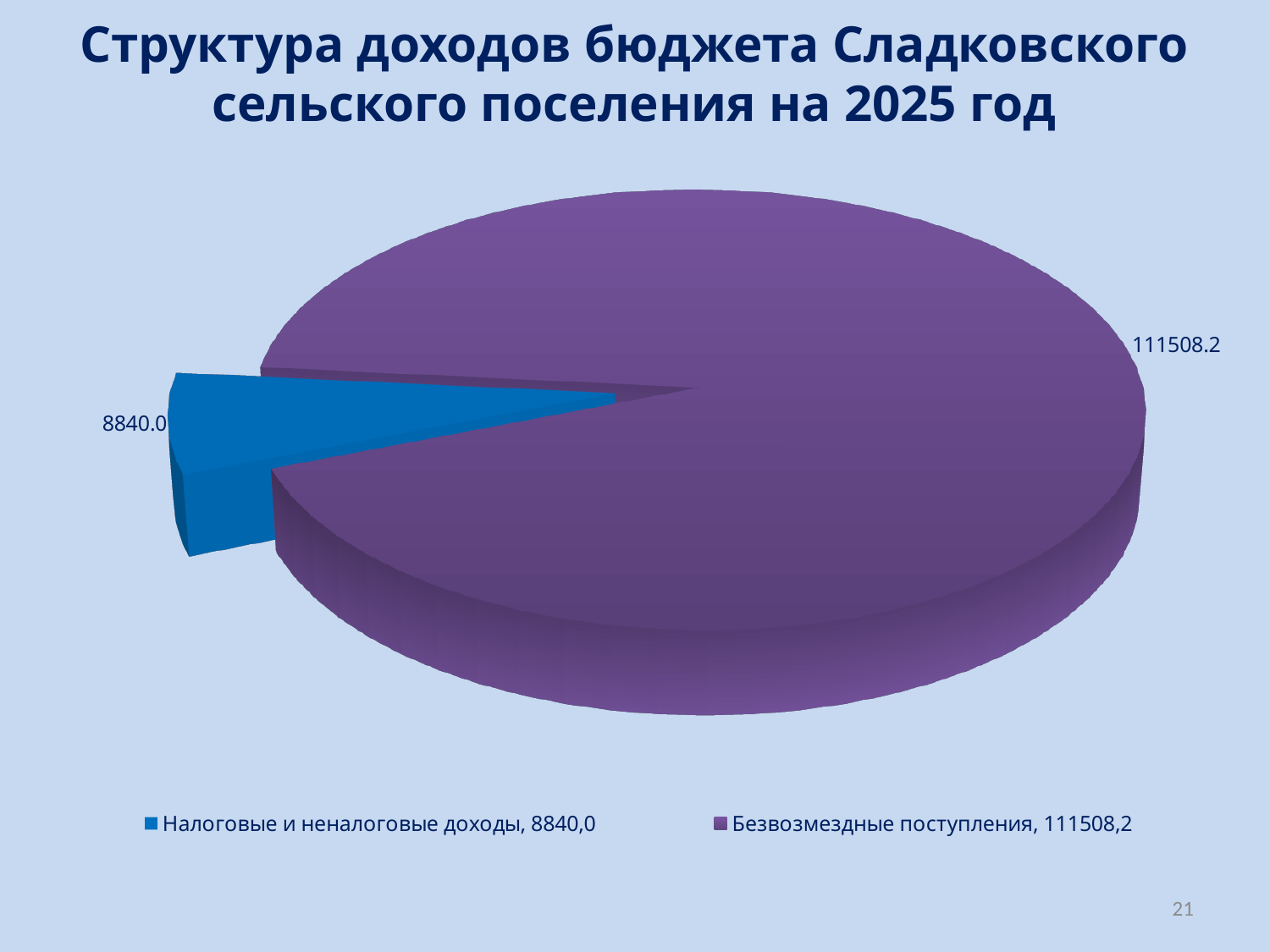
What is the total of the two values shown in the pie chart? 120348.2 What kind of chart is shown on the slide? Pie chart Which is larger: Налоговые и неналоговые доходы or Безвозмездные поступления? Безвозмездные поступления How many slices does the pie chart have? 2 What is the value for Безвозмездные поступления? 111508.2 Which category has the largest slice of the pie? Безвозмездные поступления How many entries does the legend list? 2 What colour is the slice for Налоговые и неналоговые доходы? Blue What is the value for Налоговые и неналоговые доходы? 8840.0 What is the difference between the value for Безвозмездные поступления and the value for Налоговые и неналоговые доходы? 102668.2 Which category has the smallest slice of the pie? Налоговые и неналоговые доходы What is the title of the chart on the slide? Структура доходов бюджета Сладковского сельского поселения на 2025 год